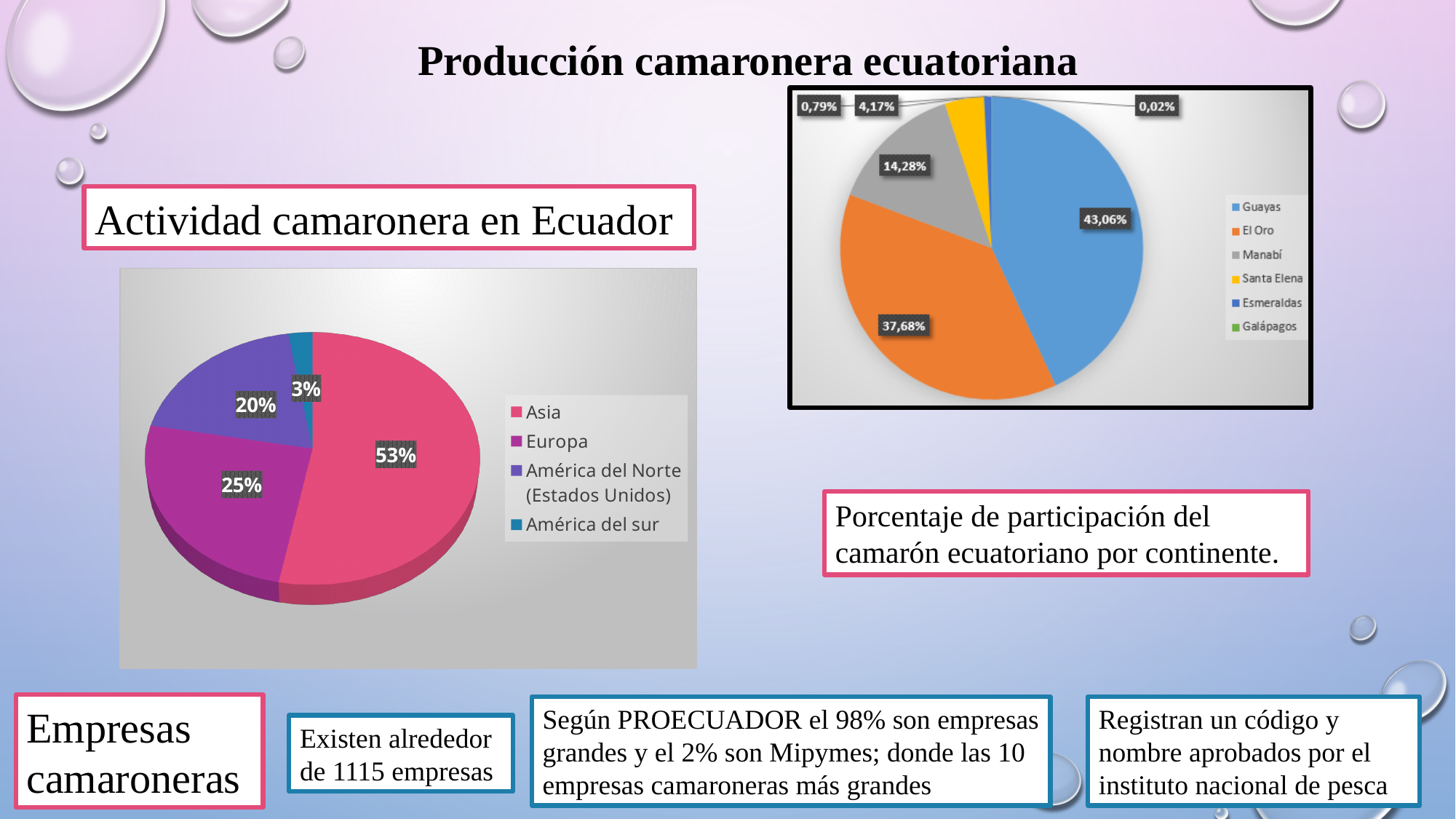
On the right pie chart, which is larger, Manabí or Santa Elena? Manabí On the left pie chart, what share does Europa have? 25% On the left pie chart, what is the difference between the shares of Asia and Europa? 28% How many categories does the legend of the right pie chart list? 6 What kind of chart is the chart on the left of the slide? Pie chart On the left pie chart, which category has the largest share? Asia How many categories does the legend of the left pie chart list? 4 On the right pie chart, what share does Guayas have? 43,06% On the left pie chart, which category has the smallest share? América del sur On the left pie chart, what share does Asia have? 53% On the right pie chart, what is the difference between the shares of Guayas and El Oro? 5,38% On the right pie chart, what share does El Oro have? 37,68%